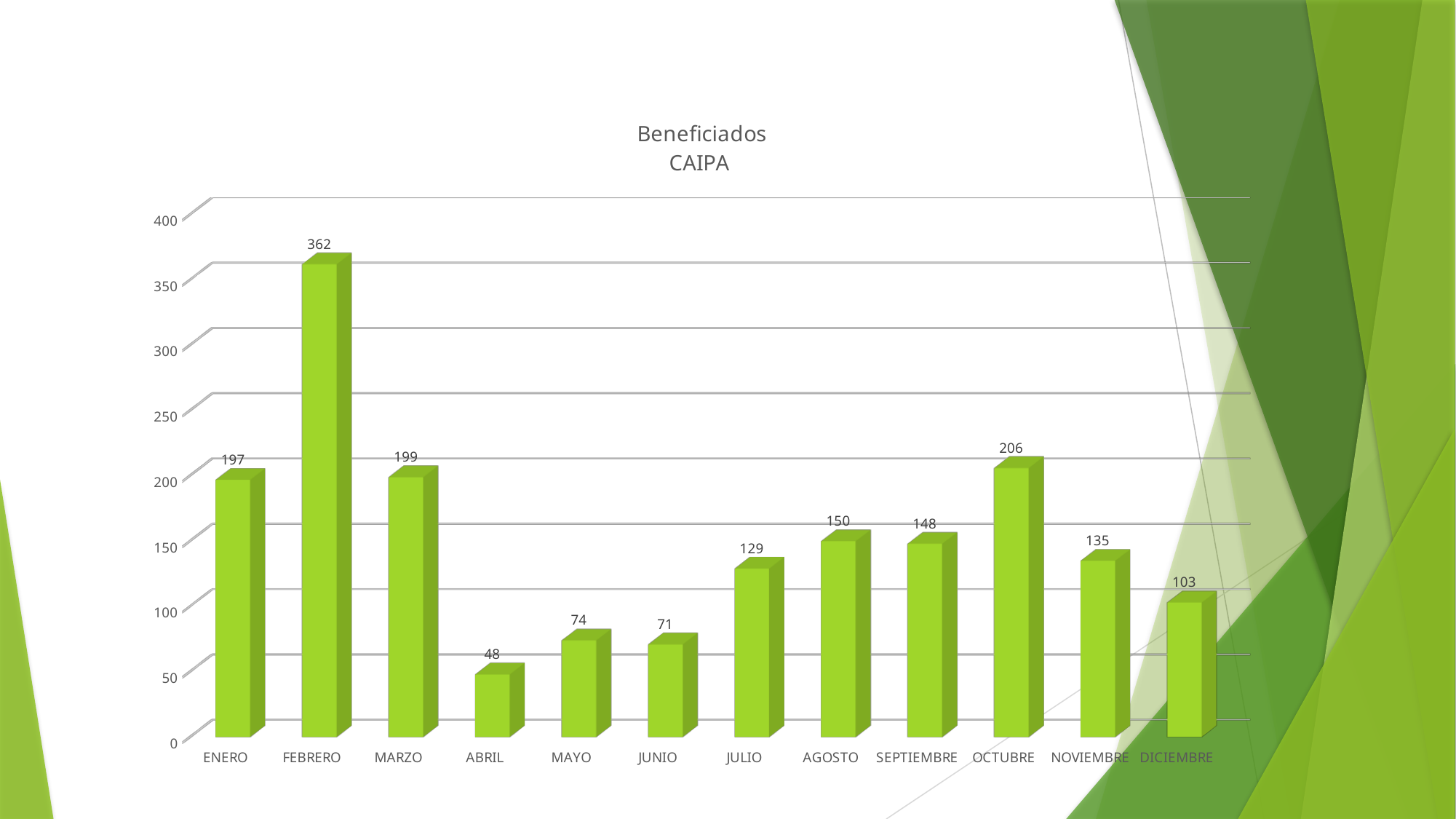
What is the value for FEBRERO? 362 Which month has the lowest value? ABRIL What is the value for OCTUBRE? 206 What is the title of the chart? Beneficiados CAIPA What is the difference between the values for FEBRERO and MARZO? 163 What kind of chart is shown on the slide? bar chart Which is larger, the value for JULIO or the value for NOVIEMBRE? NOVIEMBRE Is the value for DICIEMBRE greater or less than 150? less What is the value for ABRIL? 48 How many months are shown on the x axis? 12 Do the values rise or fall from ABRIL to AGOSTO? rise Which month has the highest value? FEBRERO